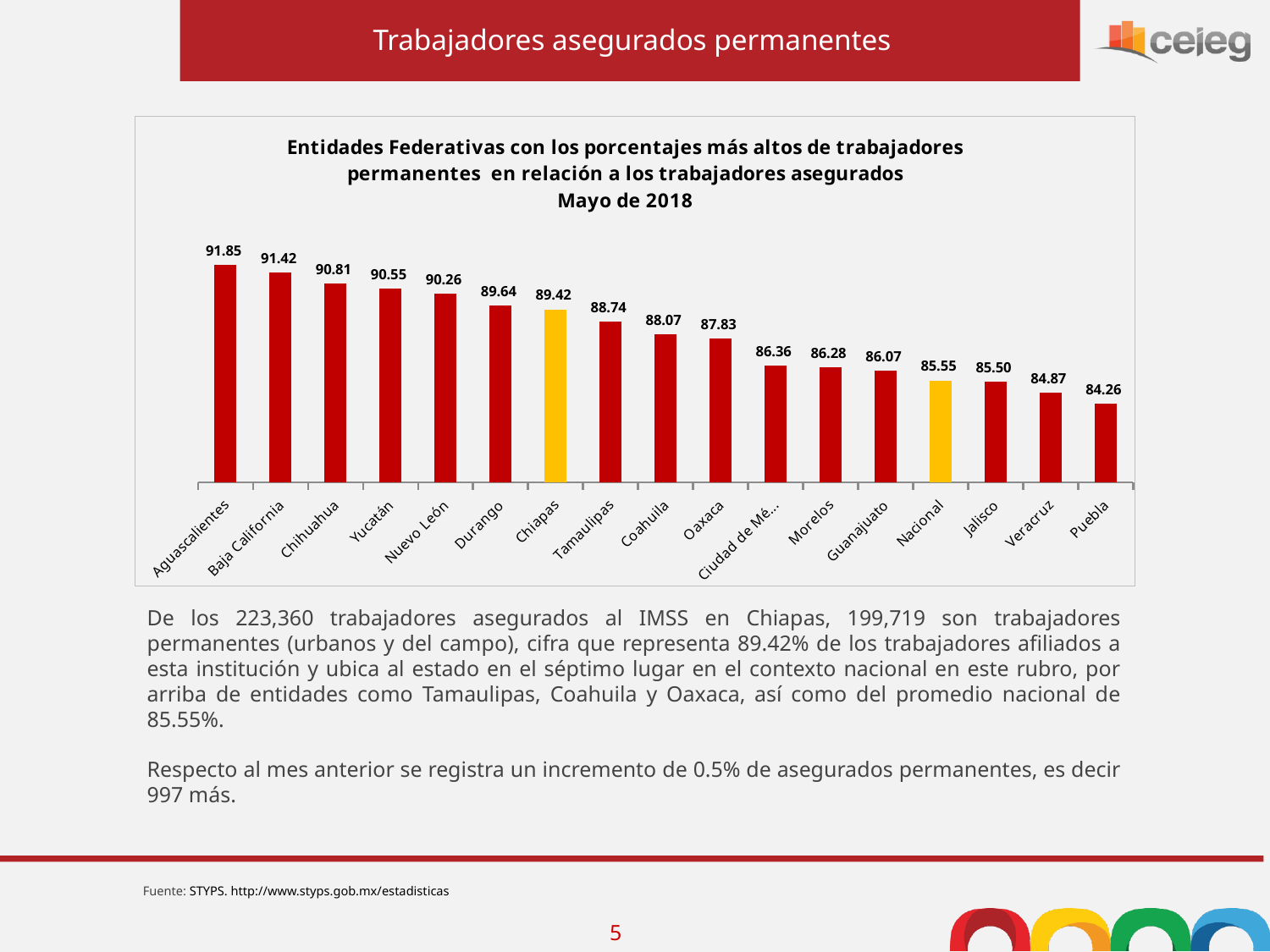
Do the values rise or fall from left to right along the x axis? Fall Which two bars are coloured yellow instead of red? Chiapas and Nacional Which category has the highest value? Aguascalientes What is the value for Nacional? 85.55 What is the difference between the values for Chiapas and Nacional? 3.87 How many categories are shown on the x axis? 17 What is the value for Yucatán? 90.55 What is the value for Chiapas? 89.42 Which category has the lowest value? Puebla What is the difference between the values for Aguascalientes and Puebla? 7.59 Which is larger, the value for Durango or the value for Tamaulipas? Durango What kind of chart is shown? Bar chart